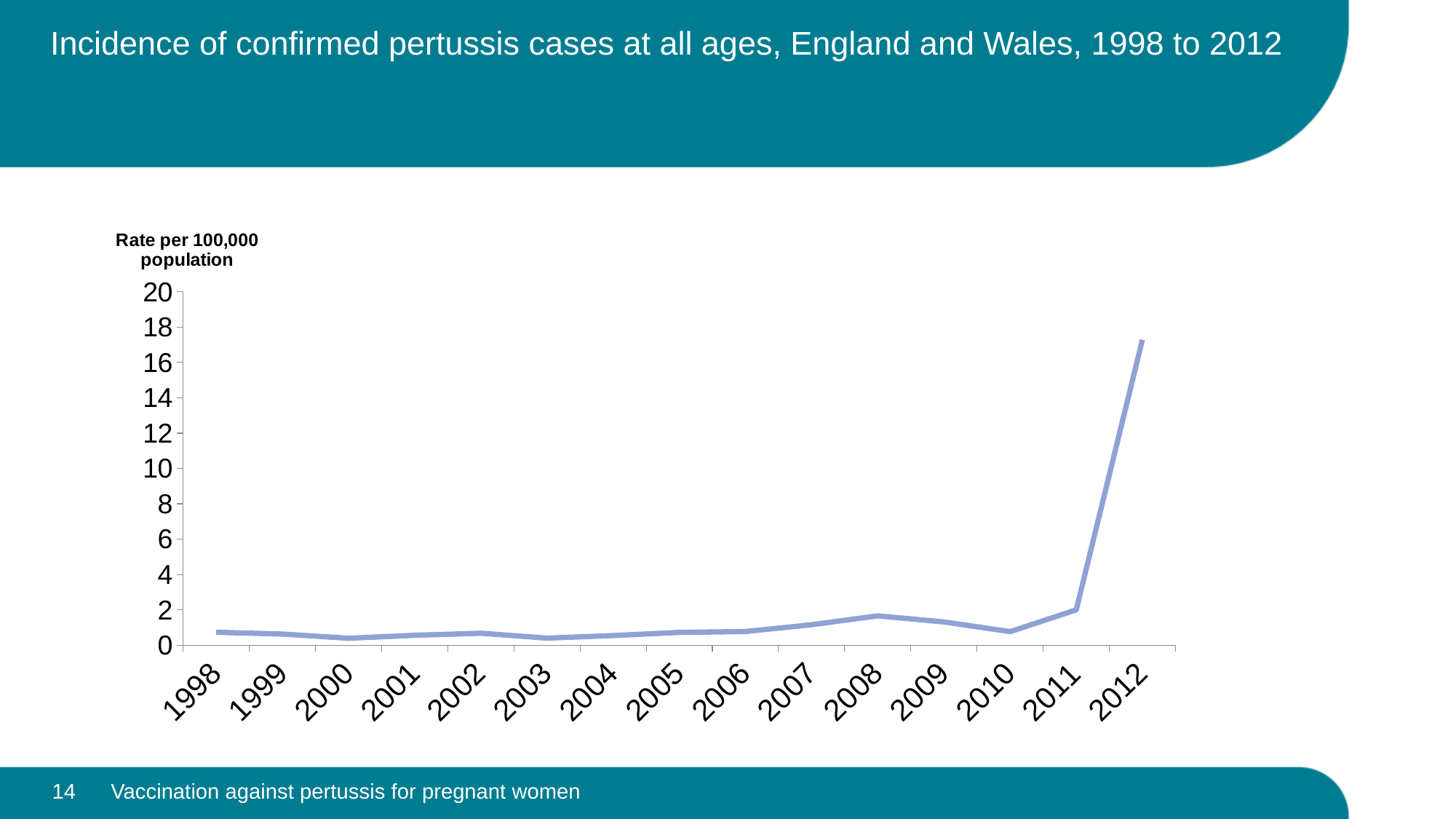
What is the label on the y axis of the chart? Rate per 100,000 population Is the value for 2012 greater or less than 16? greater Which is larger, the value for 2012 or the value for 2011? 2012 What kind of chart is shown on the slide? line chart Which year has the highest rate per 100,000 population? 2012 Which is larger, the value for 2008 or the value for 2010? 2008 How many years are plotted along the x axis? 15 Is the value for 2010 greater or less than 2? less Is the value for 2012 greater or less than 10? greater Does the rate rise or fall between 2011 and 2012? rise